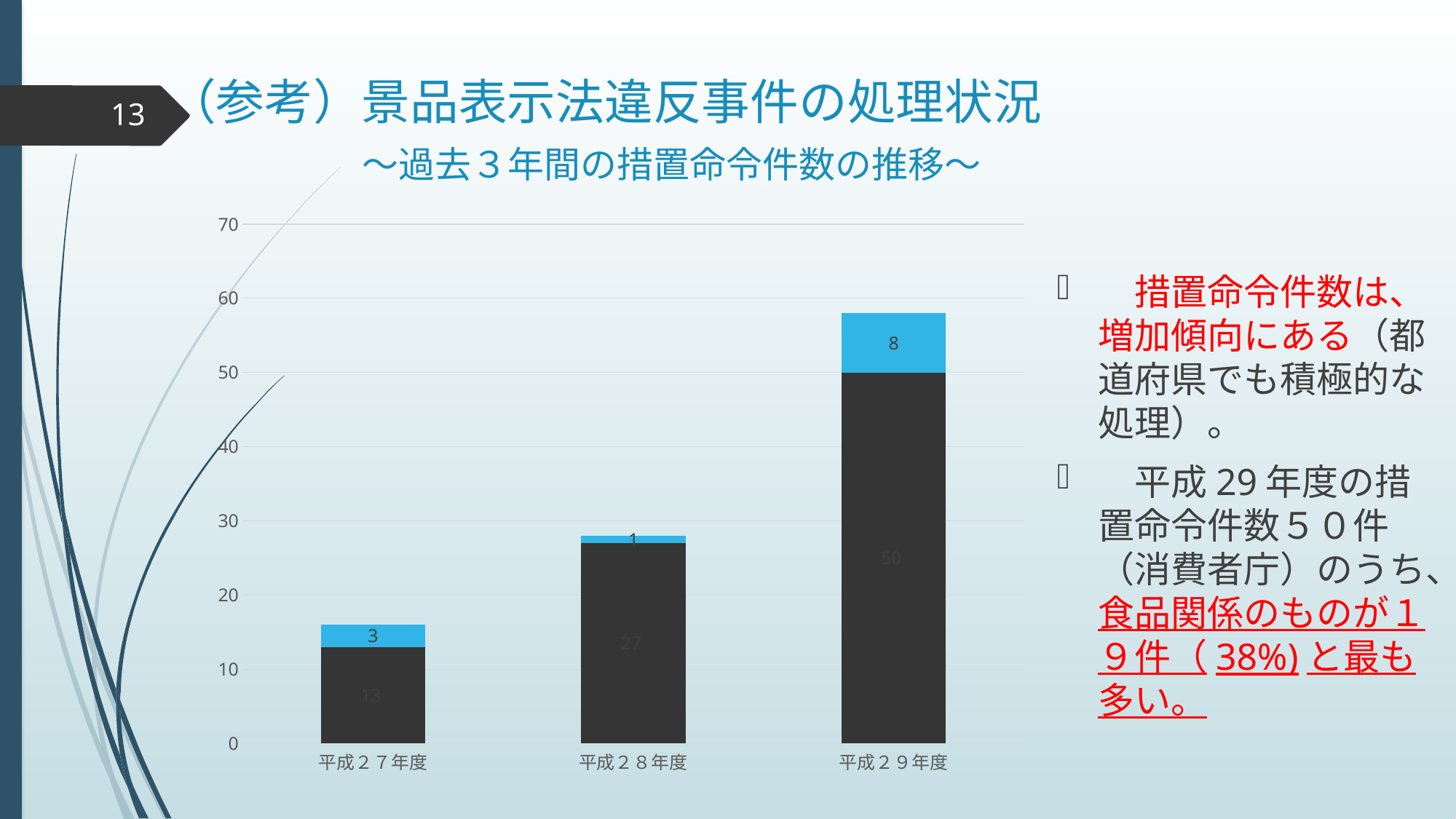
Which fiscal year has the tallest bar in the chart? 平成２９年度 What is the value of the blue segment for 平成２９年度? 8 What is the total of the stacked bar for 平成２９年度? 58 What is the value of the blue segment for 平成２７年度? 3 What is the value of the dark segment for 平成２９年度? 50 Which fiscal year has the shortest bar in the chart? 平成２７年度 What kind of chart is shown on the slide? Stacked bar chart Is the blue segment for 平成２８年度 larger or smaller than the blue segment for 平成２９年度? Smaller What is the value of the dark segment for 平成２８年度? 27 How many fiscal years (categories) are shown on the x axis of the chart? 3 Do the bar totals rise or fall from 平成２７年度 to 平成２９年度? Rise What is the difference between the dark segment values for 平成２９年度 and 平成２８年度? 23